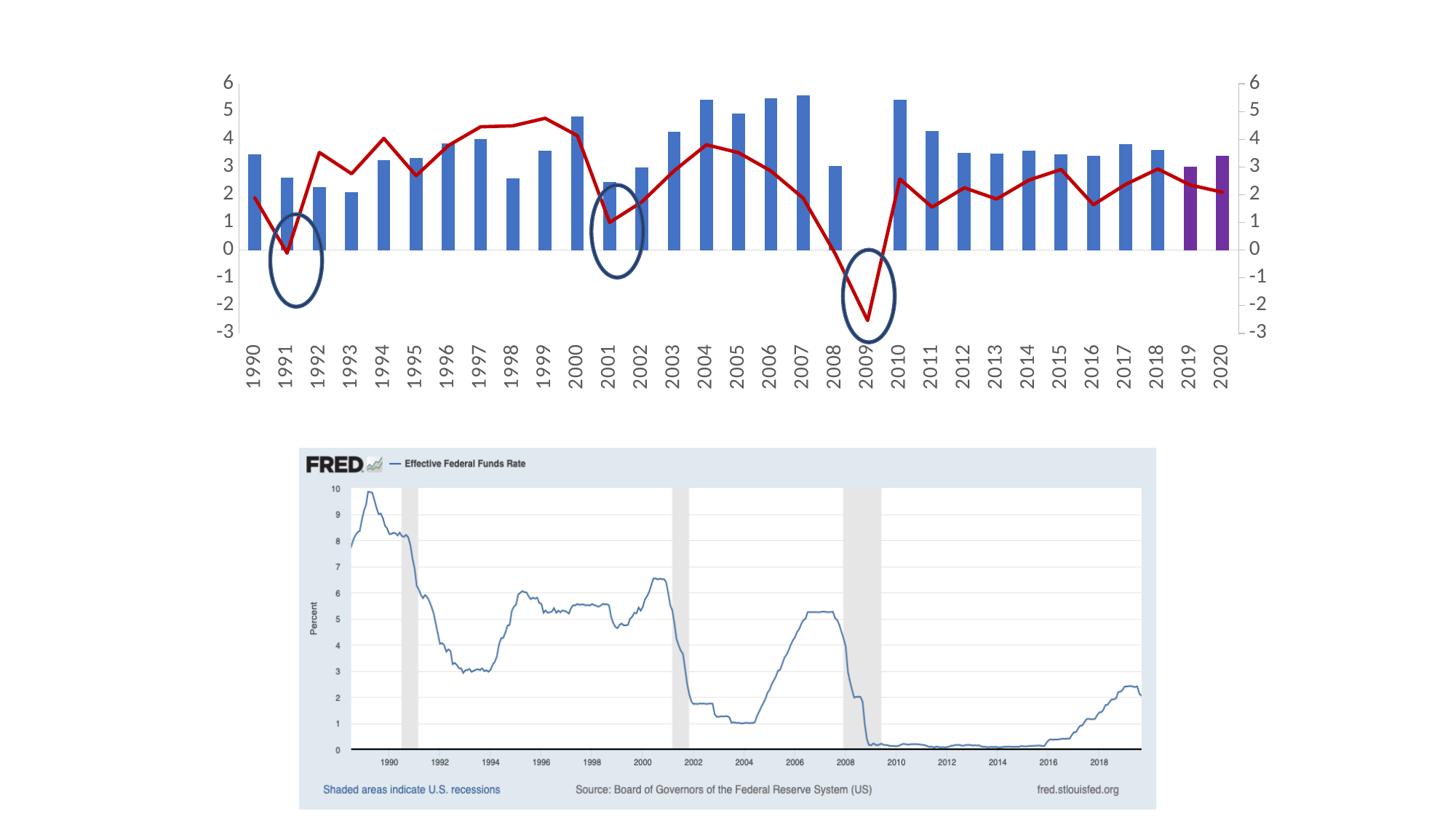
In the top chart, which year has the highest value on the red line? 1999 In the top chart, is the bar for 1993 greater or less than 3? less In the top chart, how many years are shown on the x axis? 31 In the bottom FRED chart, how many series does the legend list? 1 In the top chart, is the red line value for 2009 greater or less than -2? less In the top chart, is the bar for 2007 greater or less than 5? greater What kind of chart is the top chart on the slide? A bar chart combined with a line chart In the top chart, which bar is taller, 2004 or 2008? 2004 In the top chart, which years have bars coloured purple instead of blue? 2019 and 2020 In the bottom FRED chart, what is the name of the series plotted? Effective Federal Funds Rate In the bottom FRED chart, does the Effective Federal Funds Rate rise or fall between 2007 and 2009? fall In the top chart, which year has the lowest value on the red line? 2009